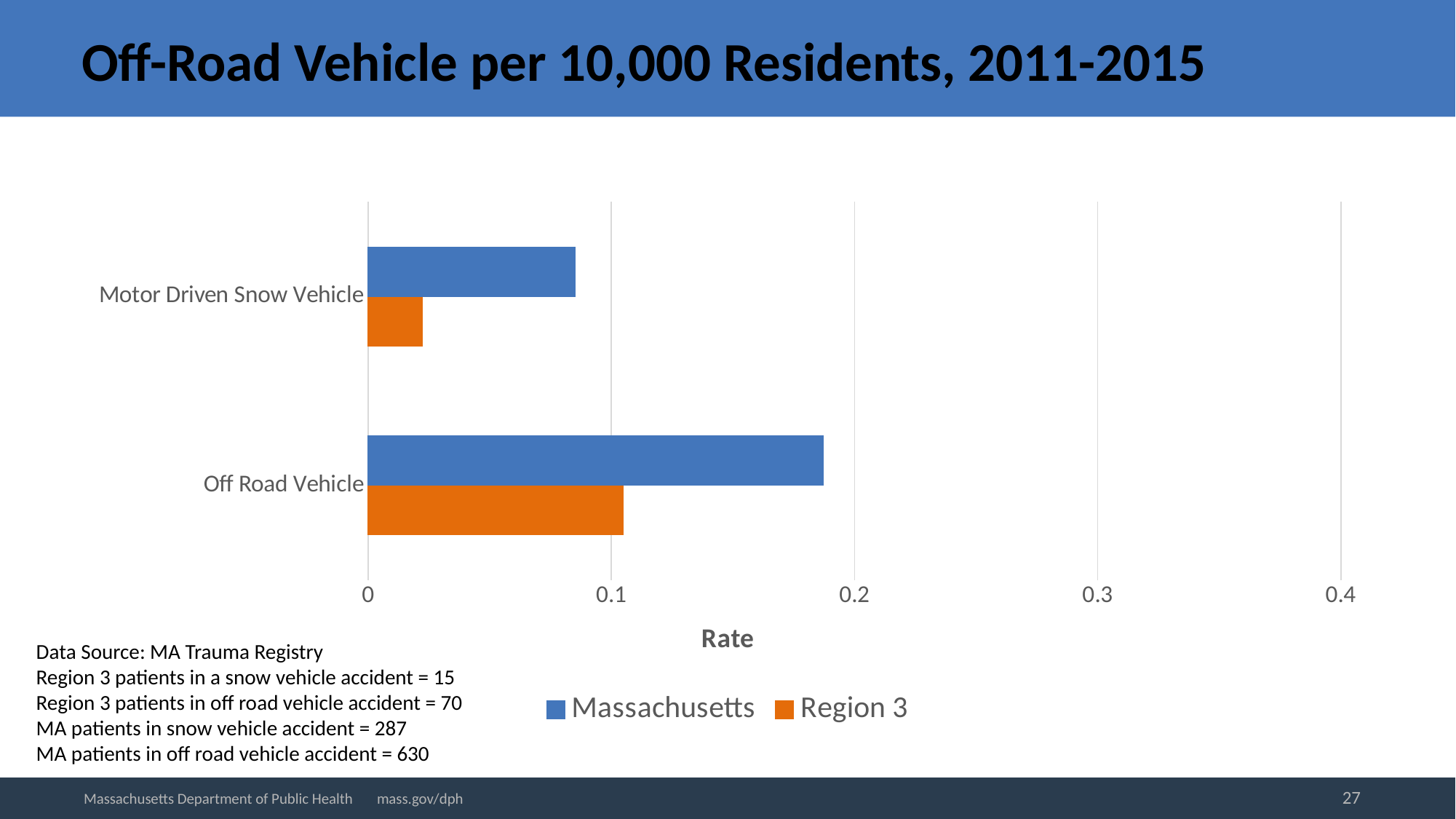
Which series has the higher rate for Motor Driven Snow Vehicle, Massachusetts or Region 3? Massachusetts What kind of chart is shown on the slide? Bar chart Is the Massachusetts rate for Motor Driven Snow Vehicle greater or less than 0.1? less Which bar on the chart is the shortest? Region 3, Motor Driven Snow Vehicle How many series does the legend list? 2 How many vehicle categories are plotted on the chart? 2 Which colour represents Region 3 in the chart? Orange Which series has the higher rate for Off Road Vehicle, Massachusetts or Region 3? Massachusetts Which bar on the chart is the longest? Massachusetts, Off Road Vehicle Is the Massachusetts rate for Off Road Vehicle greater or less than 0.2? less Is the Region 3 rate for Motor Driven Snow Vehicle greater or less than 0.1? less What is the label of the horizontal axis? Rate